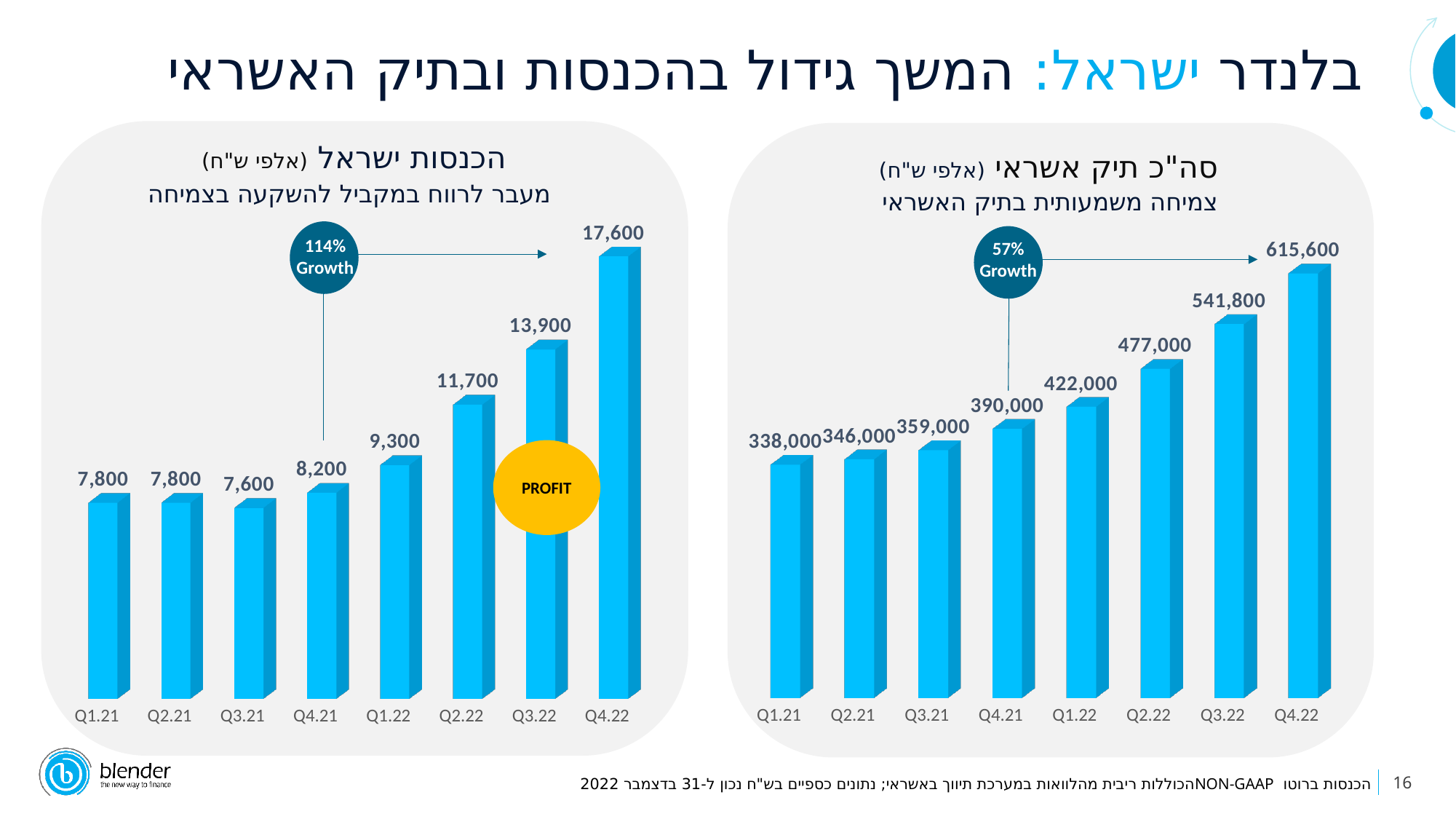
In the right chart (סה"כ תיק אשראי), what is the difference between Q4.22 and Q1.21? 277,600 In the left chart (הכנסות ישראל), which quarter has the lowest value? Q3.21 In the right chart (סה"כ תיק אשראי), which quarter has the highest value? Q4.22 In the left chart (הכנסות ישראל), what is the difference between Q4.22 and Q3.22? 3,700 In the right chart (סה"כ תיק אשראי), do the values rise or fall from Q1.21 to Q4.22? rise In the left chart (הכנסות ישראל), how many quarters are shown? 8 In the left chart (הכנסות ישראל), what is the value for Q4.22? 17,600 What type of chart is the right chart (סה"כ תיק אשראי)? bar chart In the left chart (הכנסות ישראל), what is the value for Q3.21? 7,600 In the left chart (הכנסות ישראל), what growth percentage is shown in the circle? 114% Growth In the right chart (סה"כ תיק אשראי), what is the value for Q1.21? 338,000 In the right chart (סה"כ תיק אשראי), what is the value for Q3.22? 541,800